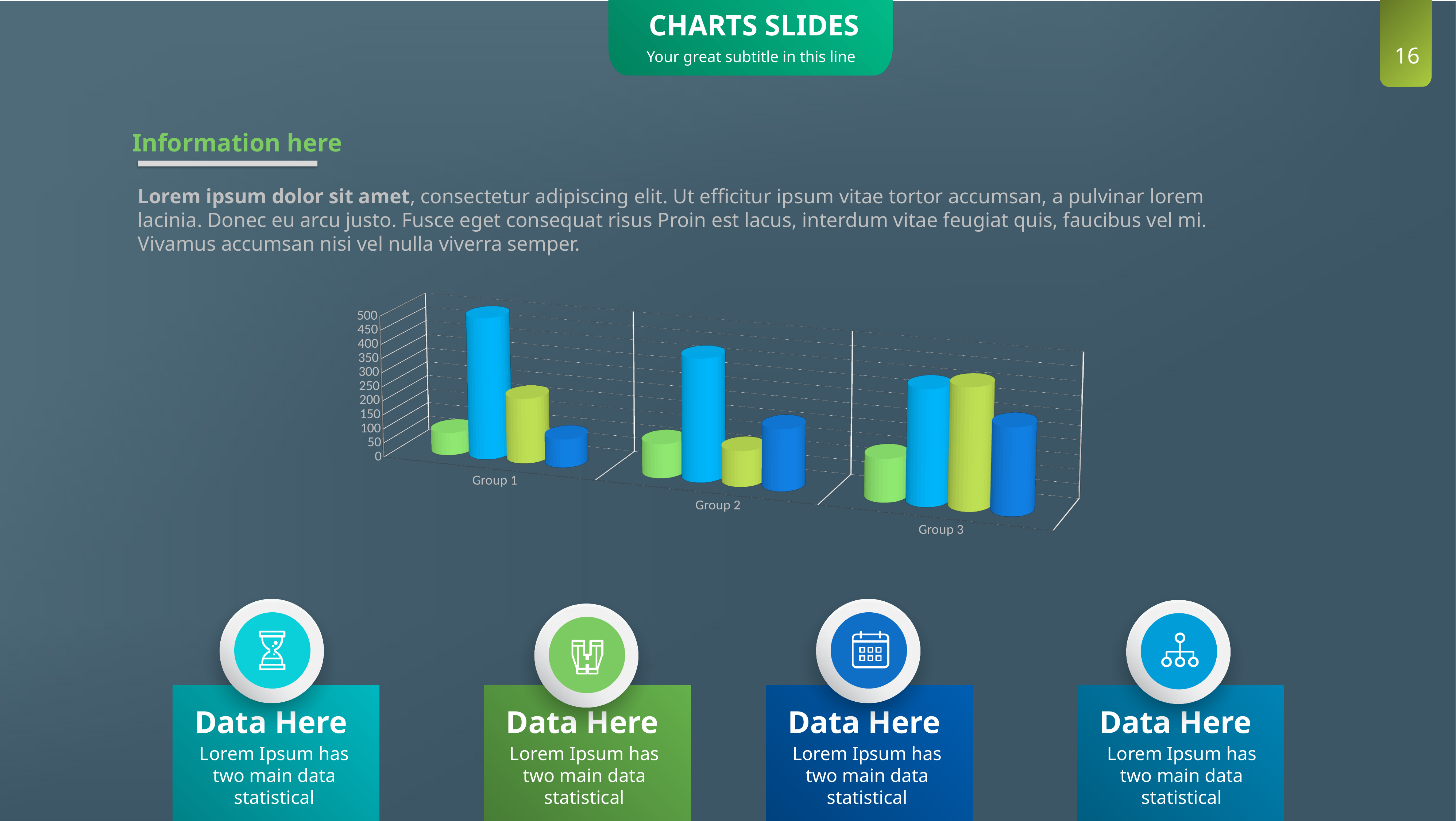
What is the highest value shown on the vertical axis of the chart? 500 Which group has the tallest light blue (cyan) bar? Group 1 How many groups (categories) are shown on the x axis of the chart? 3 What kind of chart is shown on the slide? bar chart In Group 1, is the dark blue bar greater or less than 200? less In Group 2, which is larger: the light blue (cyan) bar or the dark blue bar? the light blue (cyan) bar In Group 1, which bar is the tallest? the light blue (cyan) bar In Group 2, is the light blue (cyan) bar greater or less than 250? greater What are the category labels along the x axis of the chart? Group 1, Group 2, Group 3 In Group 3, is the green bar greater or less than 200? less How many bars are plotted for each group in the chart? 4